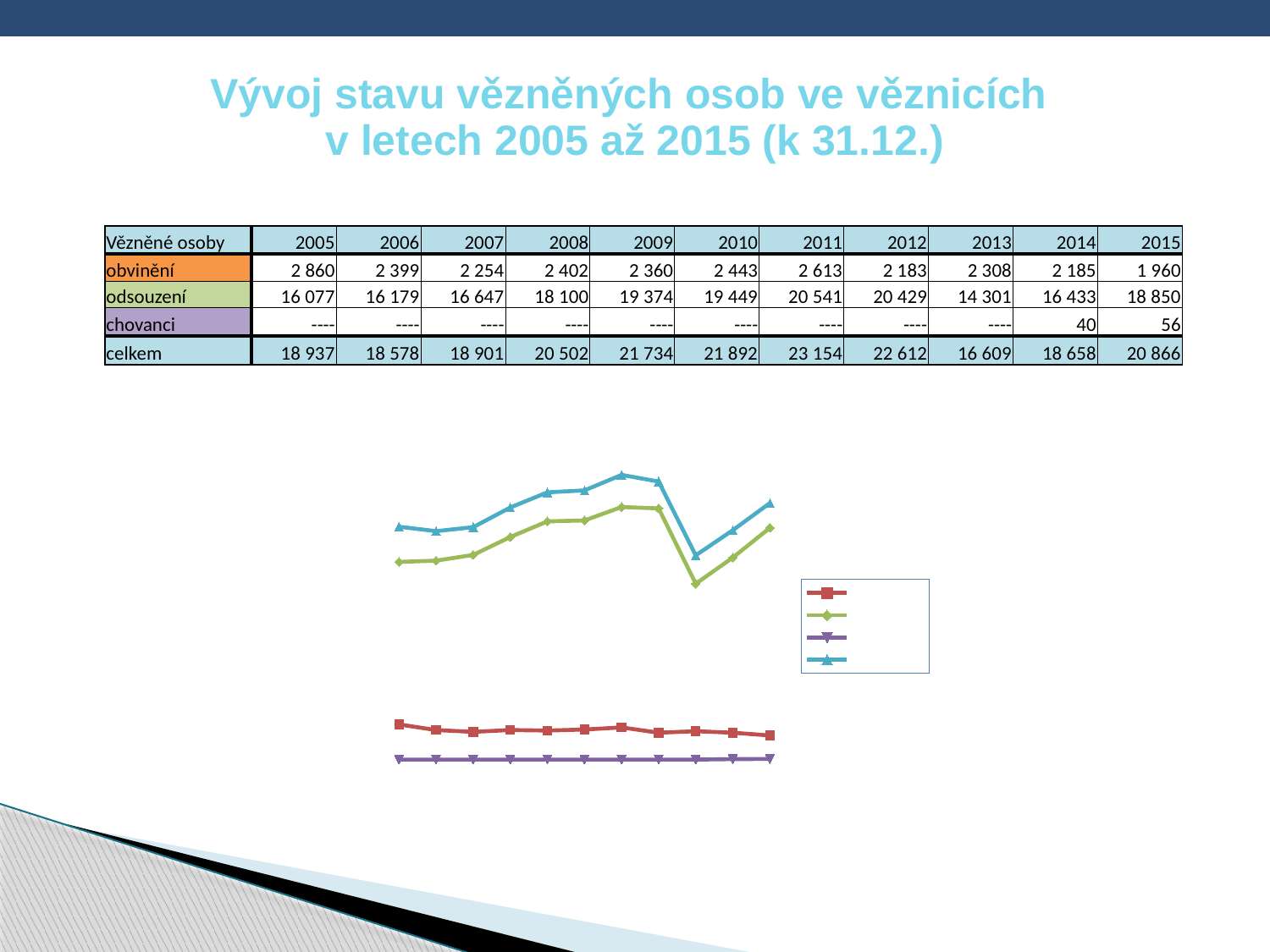
In which year is the obvinění value highest? 2005 Does the blue celkem line rise or fall from 2012 to 2013? fall How many series does the chart's legend list? 4 What colour is the line representing celkem in the chart? blue How many data points does each line in the chart have? 11 What is the value for celkem in 2011? 23 154 What is the difference between the odsouzení values for 2015 and 2014? 2 417 What kind of chart is shown on the slide? line chart In which year is the celkem value lowest? 2013 What is the value for chovanci in 2015? 56 Which is larger, the obvinění value for 2005 or for 2015? 2005 In which year is the celkem value highest? 2011